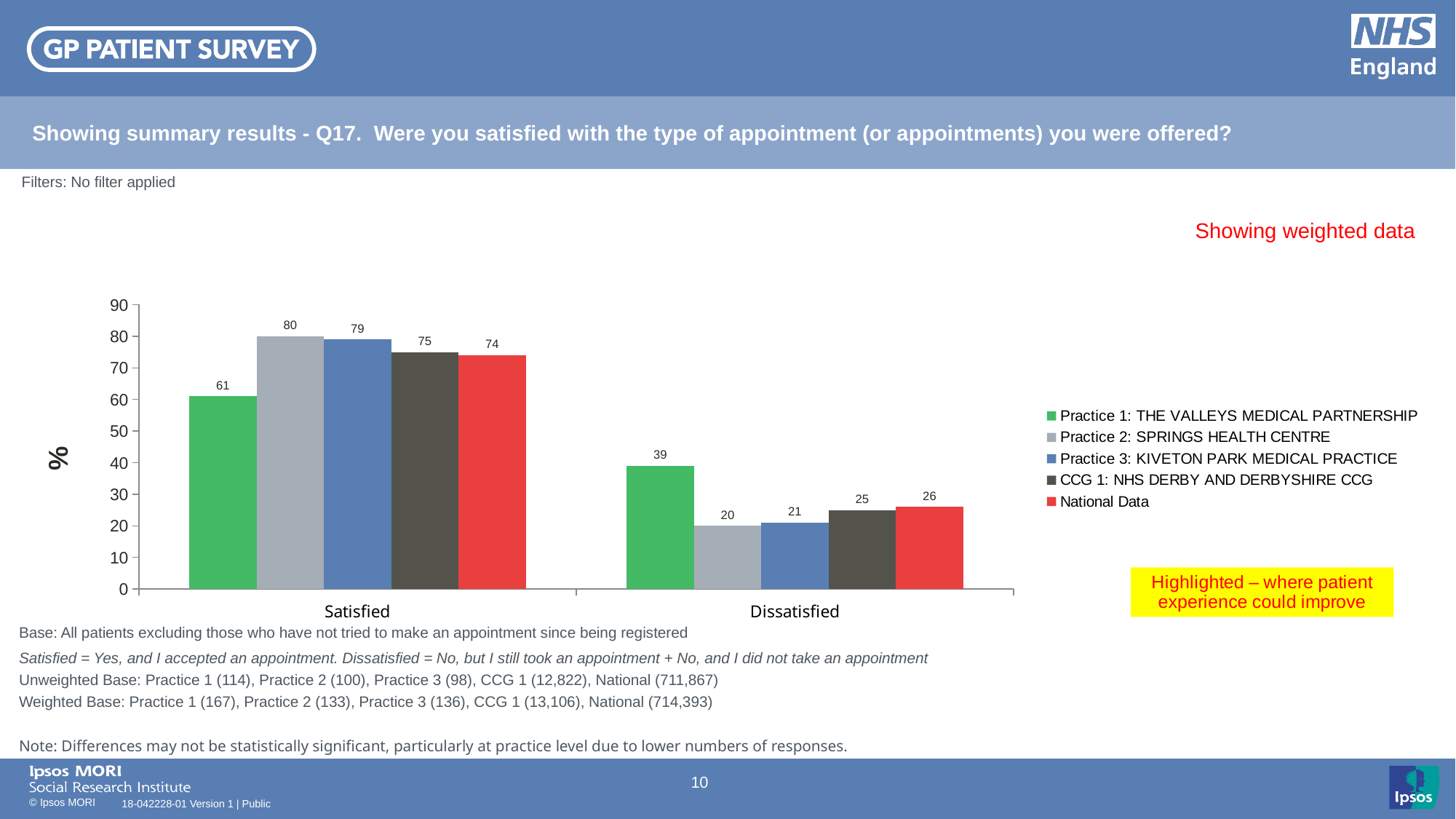
What is the Dissatisfied value for CCG 1: NHS DERBY AND DERBYSHIRE CCG? 25 How many categories are shown on the x axis? 2 What kind of chart is shown on the slide? Bar chart What colour represents National Data in the chart? Red How many series does the legend list? 5 What is the difference between the Satisfied values for Practice 2: SPRINGS HEALTH CENTRE and Practice 1: THE VALLEYS MEDICAL PARTNERSHIP? 19 Which is larger: the Dissatisfied value for Practice 1: THE VALLEYS MEDICAL PARTNERSHIP or for National Data? Practice 1: THE VALLEYS MEDICAL PARTNERSHIP What is the Satisfied value for Practice 2: SPRINGS HEALTH CENTRE? 80 Which series has the highest Satisfied value? Practice 2: SPRINGS HEALTH CENTRE What is the Satisfied value for National Data? 74 What is the Dissatisfied value for Practice 1: THE VALLEYS MEDICAL PARTNERSHIP? 39 Which series has the lowest Satisfied value? Practice 1: THE VALLEYS MEDICAL PARTNERSHIP